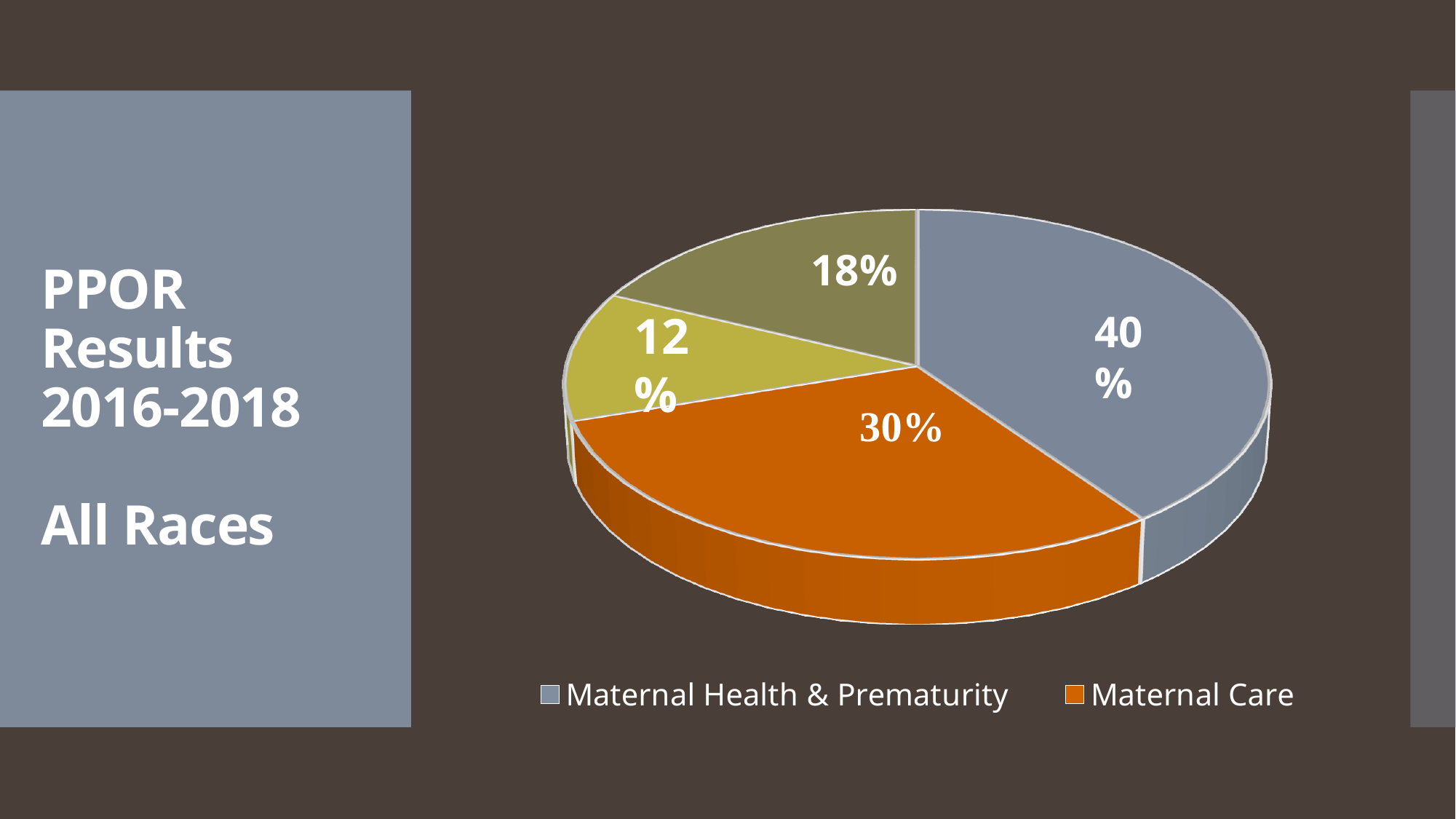
Which slice of the pie is the largest? Maternal Health & Prematurity What colour is the Maternal Care slice? orange By how many percentage points is Maternal Health & Prematurity larger than Maternal Care? 10 percentage points How many entries are listed in the legend? 2 What is the title text shown on the left of the slide? PPOR Results 2016-2018 All Races What percentage does the Maternal Health & Prematurity slice show? 40% What is the combined share of the Maternal Health & Prematurity and Maternal Care slices? 70% How many slices does the pie chart have? 4 What kind of chart is shown on the slide? pie chart What percentage does the Maternal Care slice show? 30% Which is larger, Maternal Health & Prematurity or Maternal Care? Maternal Health & Prematurity What is the value shown on the smallest slice of the pie? 12%